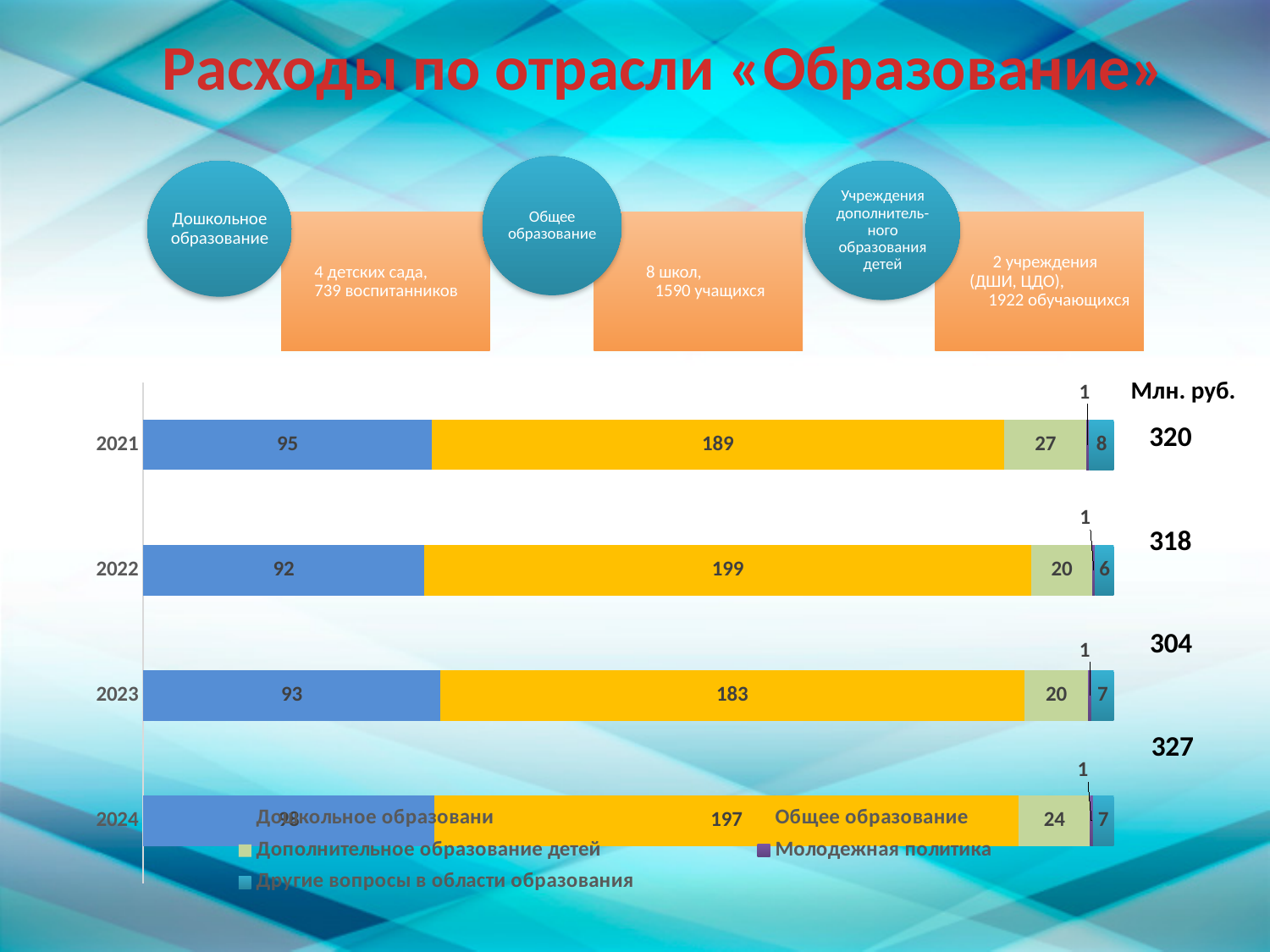
How many years are shown on the chart? 4 What is the value for Общее образование in 2022? 199 How many series does the chart legend list? 5 Which year has the highest total expenditure? 2024 What is the value for Другие вопросы в области образования in 2022? 6 What kind of chart is shown on the slide? Stacked bar chart In what units are the chart values given? Млн. руб. Which year has the larger value for Дополнительное образование детей, 2021 or 2024? 2021 What is the value for Дошкольное образование in 2021? 95 By how much did Общее образование increase from 2021 to 2022? 10 What is the total of the stacked bar for 2023? 304 Which year has the lowest total expenditure? 2023